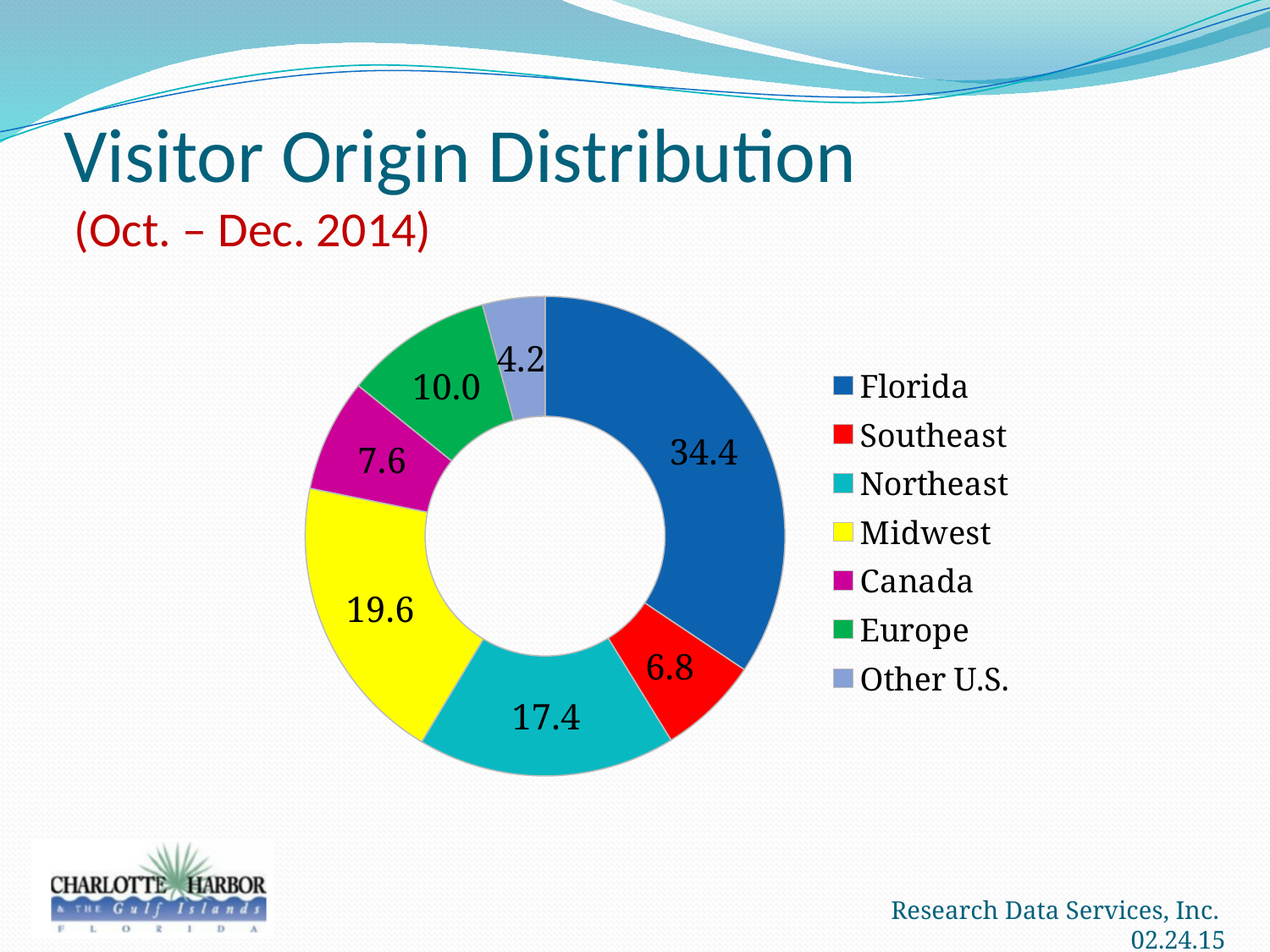
How many categories are shown in the chart? 7 Which category has the lowest value? Other U.S. Which category has the highest value? Florida What is the difference between the values for Florida and Midwest? 14.8 What kind of chart is shown on the slide? Doughnut chart What is the value for Florida? 34.4 What is the value for Other U.S.? 4.2 What is the difference between the values for Northeast and Southeast? 10.6 What is the value for Midwest? 19.6 What is the value for Canada? 7.6 Which is larger, the value for Europe or the value for Canada? Europe What colour represents Midwest in the chart? Yellow